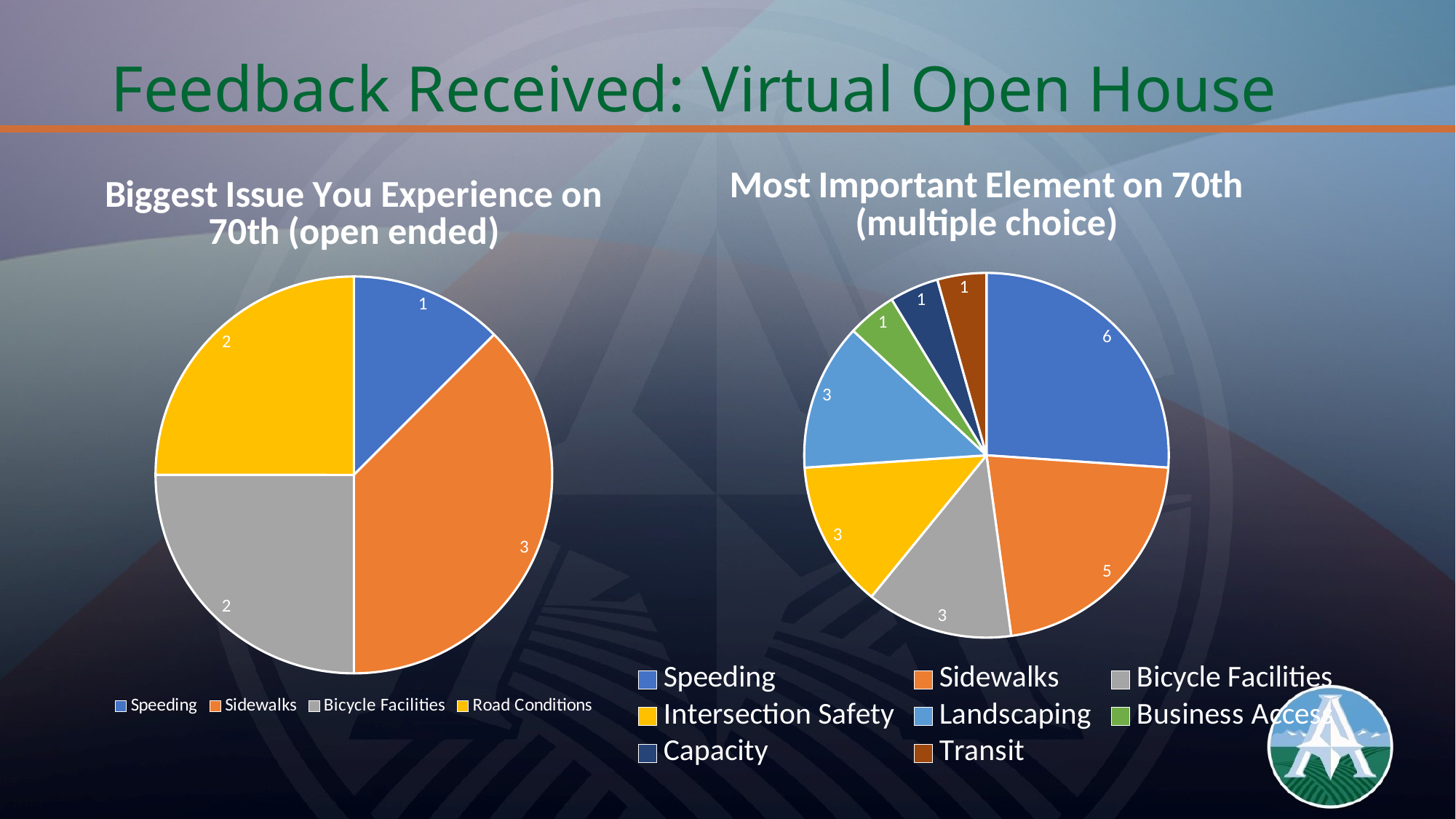
In the 'Most Important Element on 70th (multiple choice)' chart, which is larger, Sidewalks or Landscaping? Sidewalks In the 'Most Important Element on 70th (multiple choice)' chart, what colour is the Transit slice? Brown In the 'Biggest Issue You Experience on 70th (open ended)' chart, which category has the lowest value? Speeding In the 'Biggest Issue You Experience on 70th (open ended)' chart, what is the value for Sidewalks? 3 In the 'Most Important Element on 70th (multiple choice)' chart, which category has the highest value? Speeding How many categories does the 'Biggest Issue You Experience on 70th (open ended)' chart show? 4 In the 'Biggest Issue You Experience on 70th (open ended)' chart, what is the difference between Sidewalks and Speeding? 2 In the 'Most Important Element on 70th (multiple choice)' chart, what is the value for Speeding? 6 What kind of chart is used for 'Biggest Issue You Experience on 70th (open ended)'? Pie chart How many categories does the 'Most Important Element on 70th (multiple choice)' chart show? 8 In the 'Biggest Issue You Experience on 70th (open ended)' chart, what share of the total does Sidewalks represent? 37.5% In the 'Most Important Element on 70th (multiple choice)' chart, what is the difference between Speeding and Sidewalks? 1